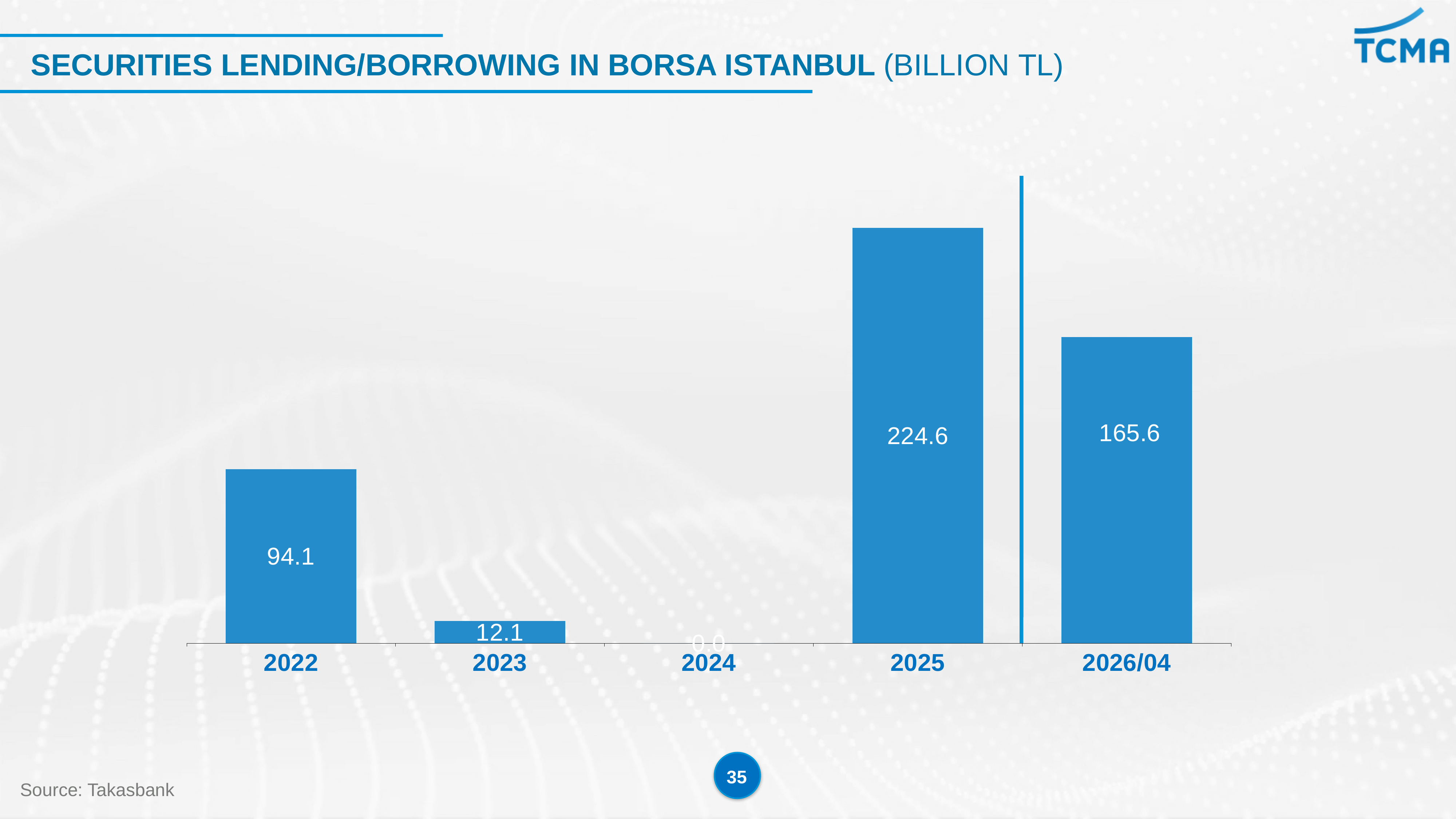
Which year has the lowest value? 2024 What is the value for 2023? 12.1 Which is larger, the value for 2022 or the value for 2026/04? 2026/04 What is the difference between the values for 2025 and 2026/04? 59.0 What kind of chart is shown on the slide? bar chart Which year has the highest value? 2025 What is the value for 2022? 94.1 What is the difference between the values for 2022 and 2023? 82.0 What is the source cited for the chart? Takasbank What is the value for 2025? 224.6 How many years are shown on the x axis? 5 What is the value for 2026/04? 165.6